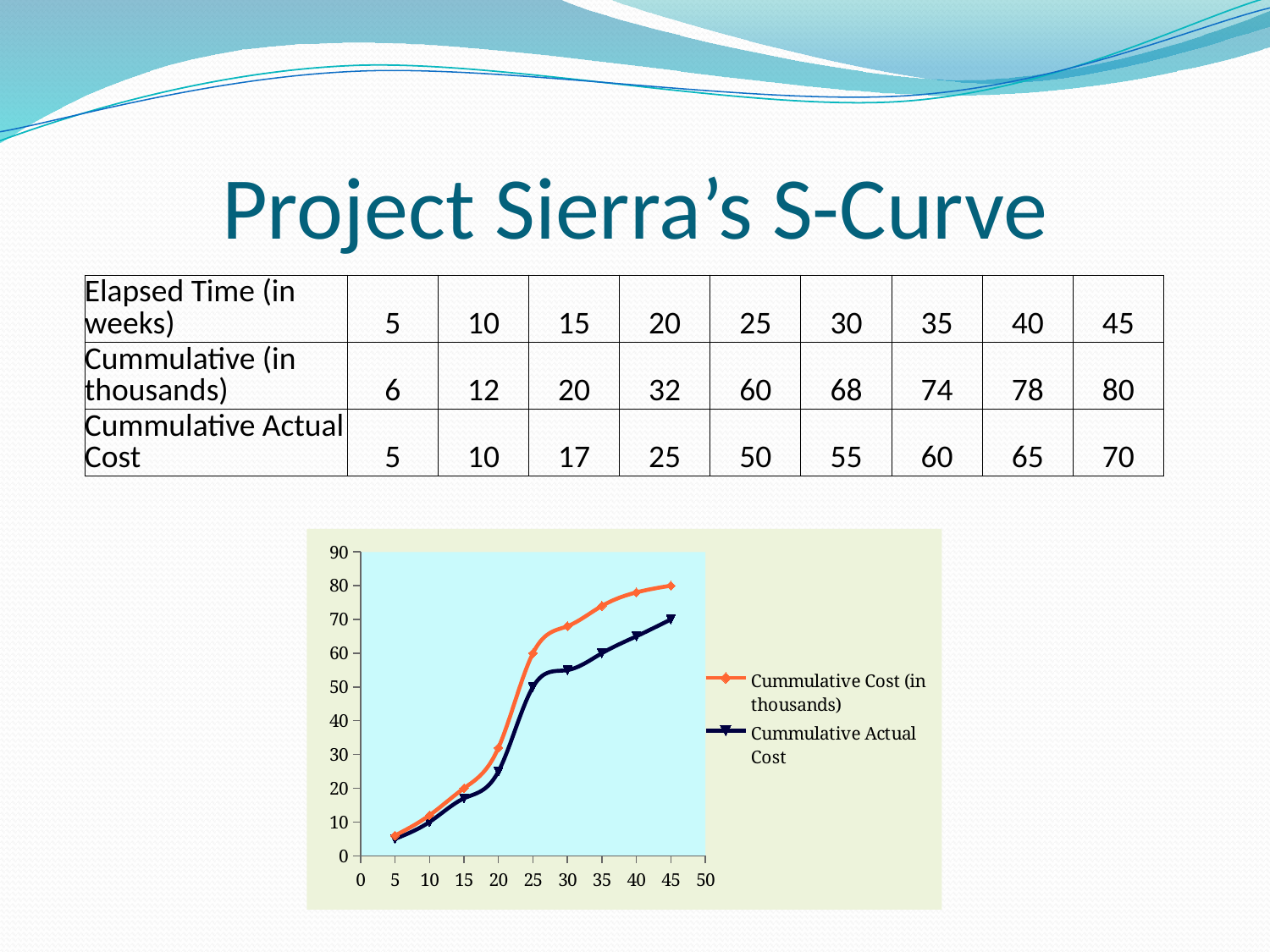
At 45 weeks, what is the difference between the Cummulative Cost (in thousands) and the Cummulative Actual Cost? 10 What kind of chart is shown on the slide? line chart Do the values of the Cummulative Actual Cost series rise or fall as elapsed time increases? rise How many data points are plotted for the Cummulative Cost (in thousands) series? 9 At which elapsed time (in weeks) does the Cummulative Cost (in thousands) reach its highest value? 45 How many series does the chart's legend list? 2 What is the Cummulative Cost (in thousands) at 25 weeks? 60 Is the Cummulative Cost (in thousands) at 35 weeks greater or less than 70? greater At 20 weeks, which series has the higher value: Cummulative Cost (in thousands) or Cummulative Actual Cost? Cummulative Cost (in thousands) What is the Cummulative Actual Cost at 45 weeks? 70 Is the Cummulative Actual Cost at 30 weeks greater or less than 60? less What is the title of the slide containing the chart? Project Sierra's S-Curve